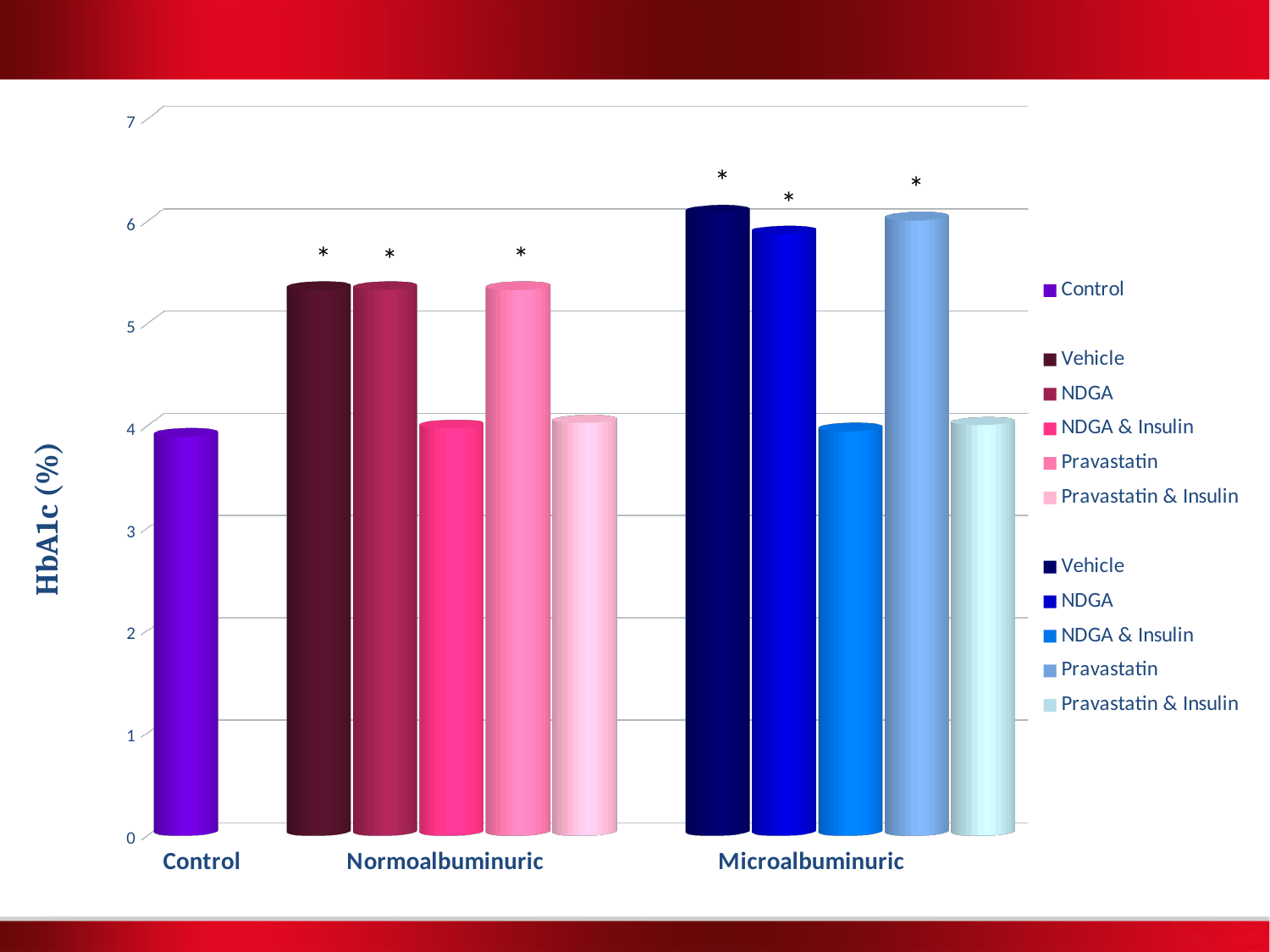
Is the NDGA & Insulin value in the Normoalbuminuric group greater or less than 5? less Which is larger: the Vehicle value in the Microalbuminuric group or the Vehicle value in the Normoalbuminuric group? Microalbuminuric Vehicle Which is larger in the Normoalbuminuric group: the Vehicle value or the NDGA & Insulin value? Vehicle What kind of chart is shown on the slide? bar chart How many bars are marked with an asterisk? 6 How many entries does the legend list? 11 Is the Vehicle value in the Normoalbuminuric group greater or less than 5? greater What is the label on the vertical axis of the chart? HbA1c (%) How many category groups are shown along the x axis? 3 Is the Vehicle value in the Microalbuminuric group greater or less than 5? greater